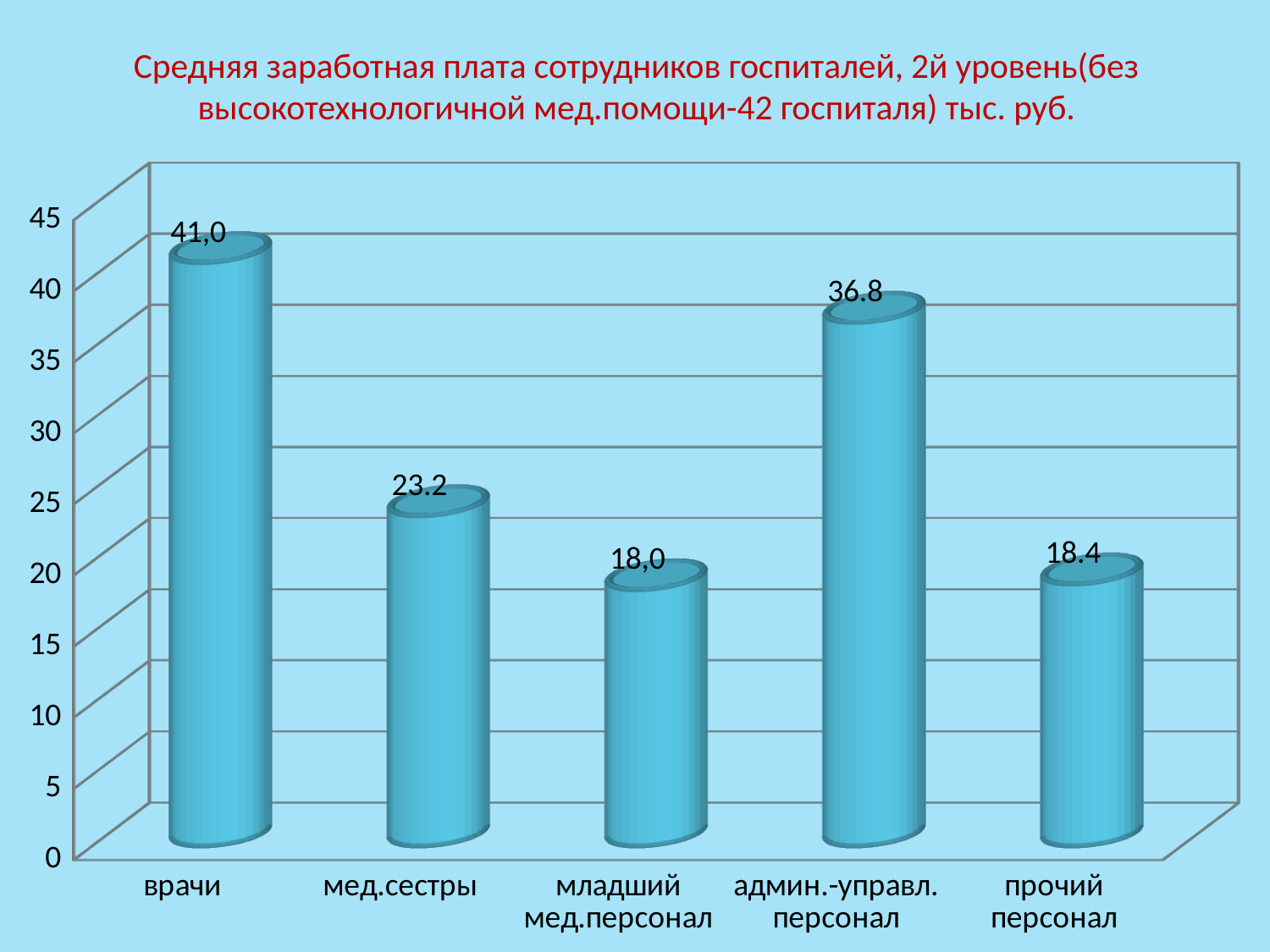
What value is shown for админ.-управл. персонал? 36.8 What is the average salary shown for врачи? 41,0 How many categories are shown on the x axis? 5 What kind of chart is shown on the slide? bar chart What value is shown for младший мед.персонал? 18,0 What is the difference between the values for мед.сестры and прочий персонал? 4.8 Which category has the highest average salary? врачи Which is larger, the value for мед.сестры or the value for админ.-управл. персонал? админ.-управл. персонал What is the difference between the values for врачи and админ.-управл. персонал? 4.2 What value is shown for прочий персонал? 18.4 What value is shown for мед.сестры? 23.2 Is the value for мед.сестры greater or less than 25? less